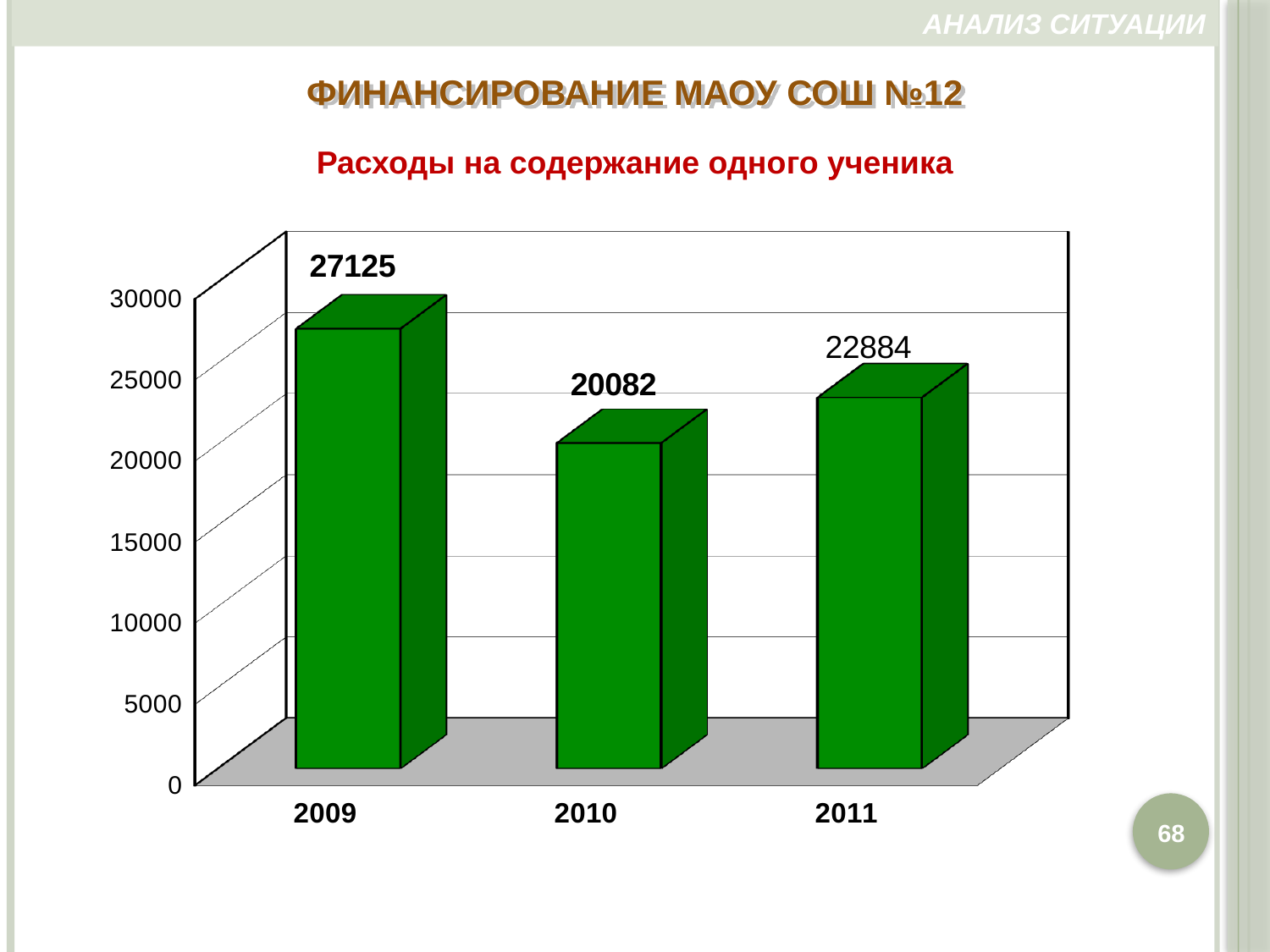
What is the value for 2009? 27125 What kind of chart is shown on the slide? bar chart Which year has the lowest value? 2010 What is the subtitle of the chart shown in red? Расходы на содержание одного ученика What is the difference between the values for 2011 and 2010? 2802 What is the value for 2010? 20082 What is the difference between the values for 2009 and 2010? 7043 Which is larger, the value for 2011 or the value for 2010? 2011 Is the value for 2009 greater or less than 25000? greater What is the value for 2011? 22884 How many years are shown on the x axis? 3 Which year has the highest value? 2009